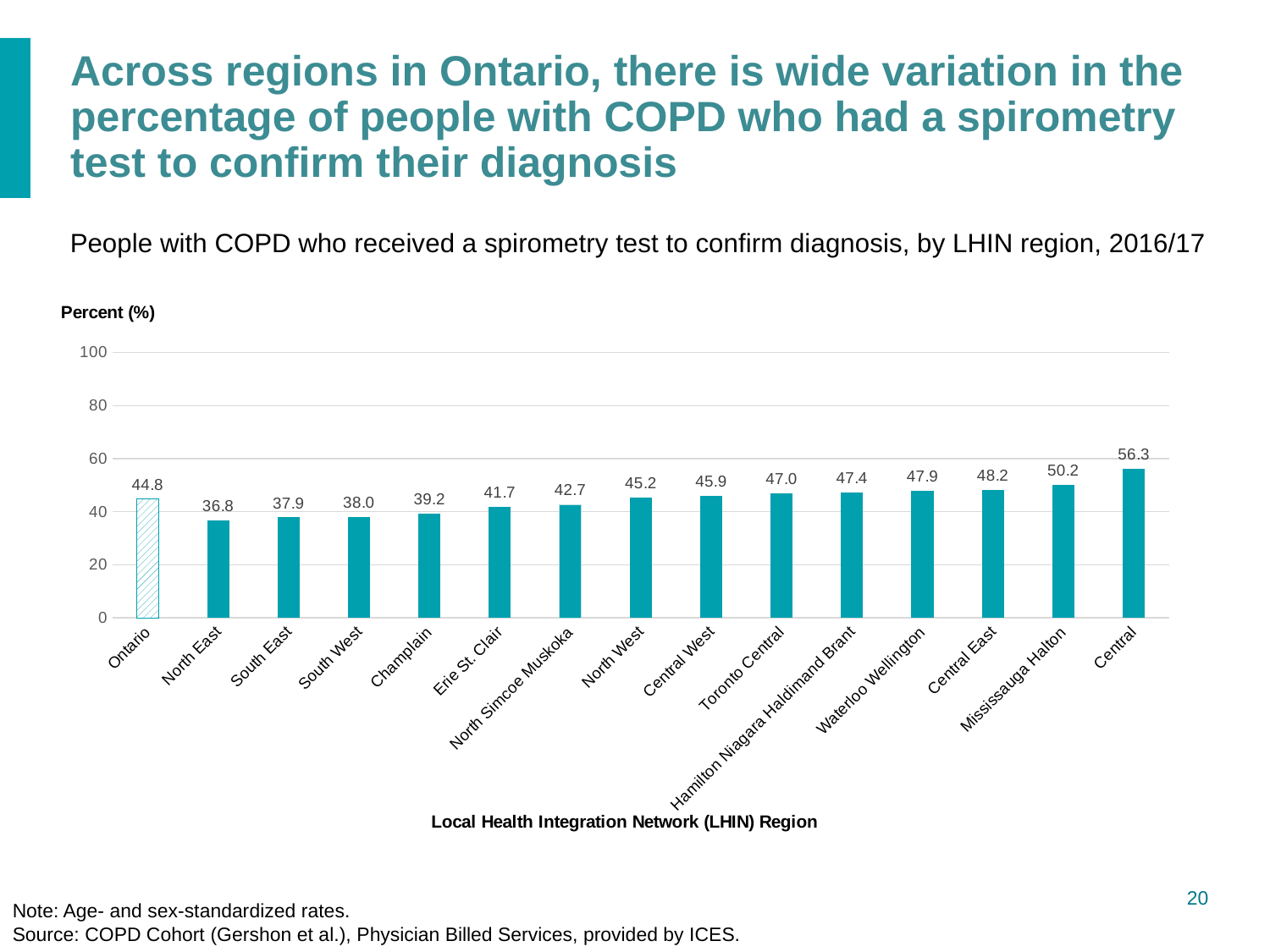
What is the value for Hamilton Niagara Haldimand Brant? 47.4 Is the value for Mississauga Halton greater or less than 40? greater Do the values for the LHIN regions (excluding Ontario) rise or fall from left to right? rise What is the value for Champlain? 39.2 What is the value for Ontario? 44.8 What is the label of the x axis? Local Health Integration Network (LHIN) Region What kind of chart is this? bar chart Which LHIN region has the highest value? Central What is the difference between the values for Central and North East? 19.5 Which is larger, the value for Toronto Central or the value for Erie St. Clair? Toronto Central Which LHIN region has the lowest value? North East How many categories are shown on the x axis? 15